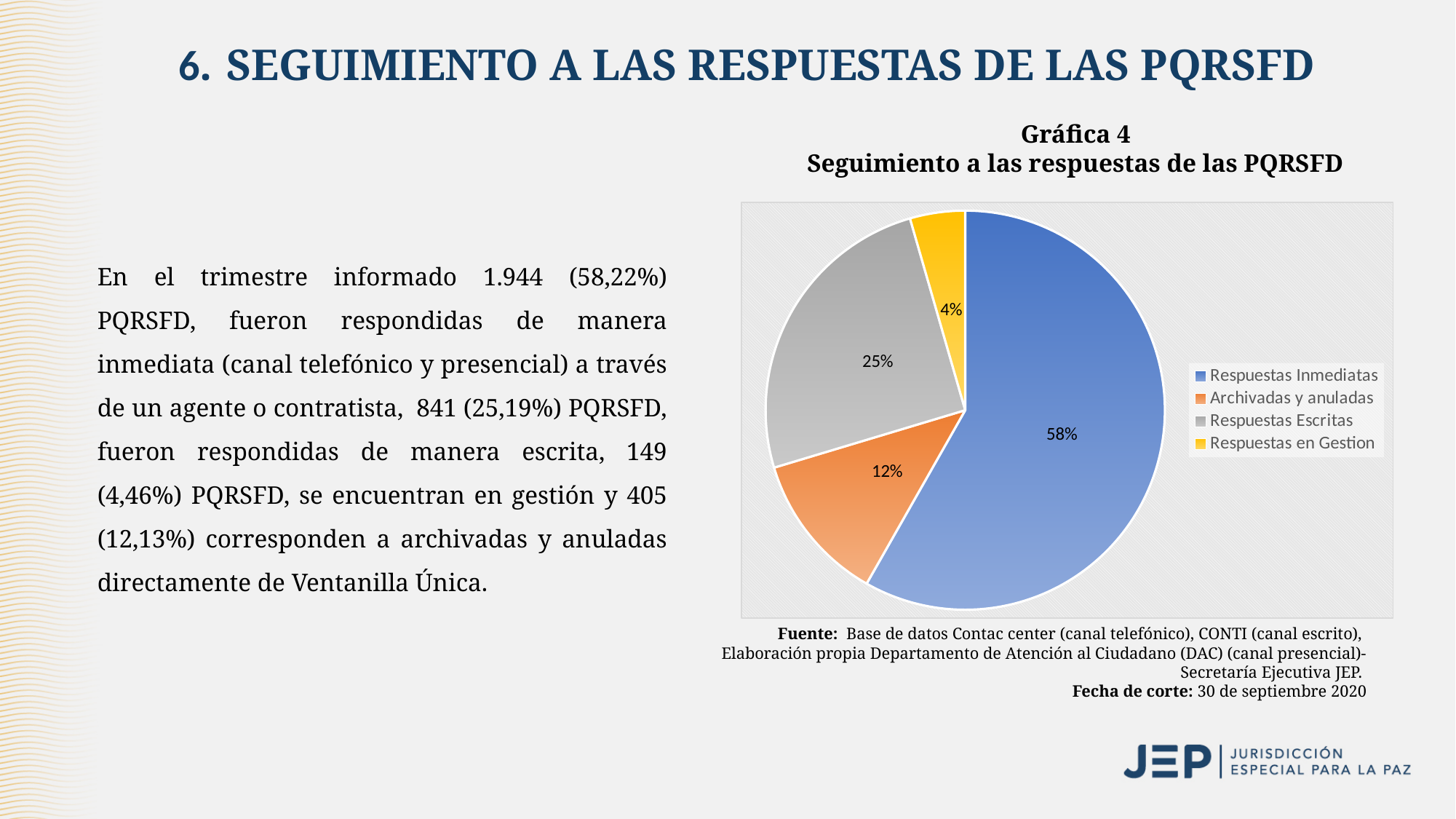
What share of the pie is labelled for Respuestas en Gestion? 4% What share of the pie is labelled for Respuestas Inmediatas? 58% How many categories does the legend list? 4 Which is larger, the slice for Respuestas Escritas or the slice for Archivadas y anuladas? Respuestas Escritas What is the difference in percentage points between the Respuestas Inmediatas slice and the Respuestas Escritas slice? 33 percentage points What share of the pie is labelled for Archivadas y anuladas? 12% Which category has the largest slice of the pie? Respuestas Inmediatas Which category has the smallest slice of the pie? Respuestas en Gestion What is the title of the chart? Gráfica 4 Seguimiento a las respuestas de las PQRSFD What kind of chart is shown on the slide? pie chart What colour is the slice for Respuestas en Gestion? yellow